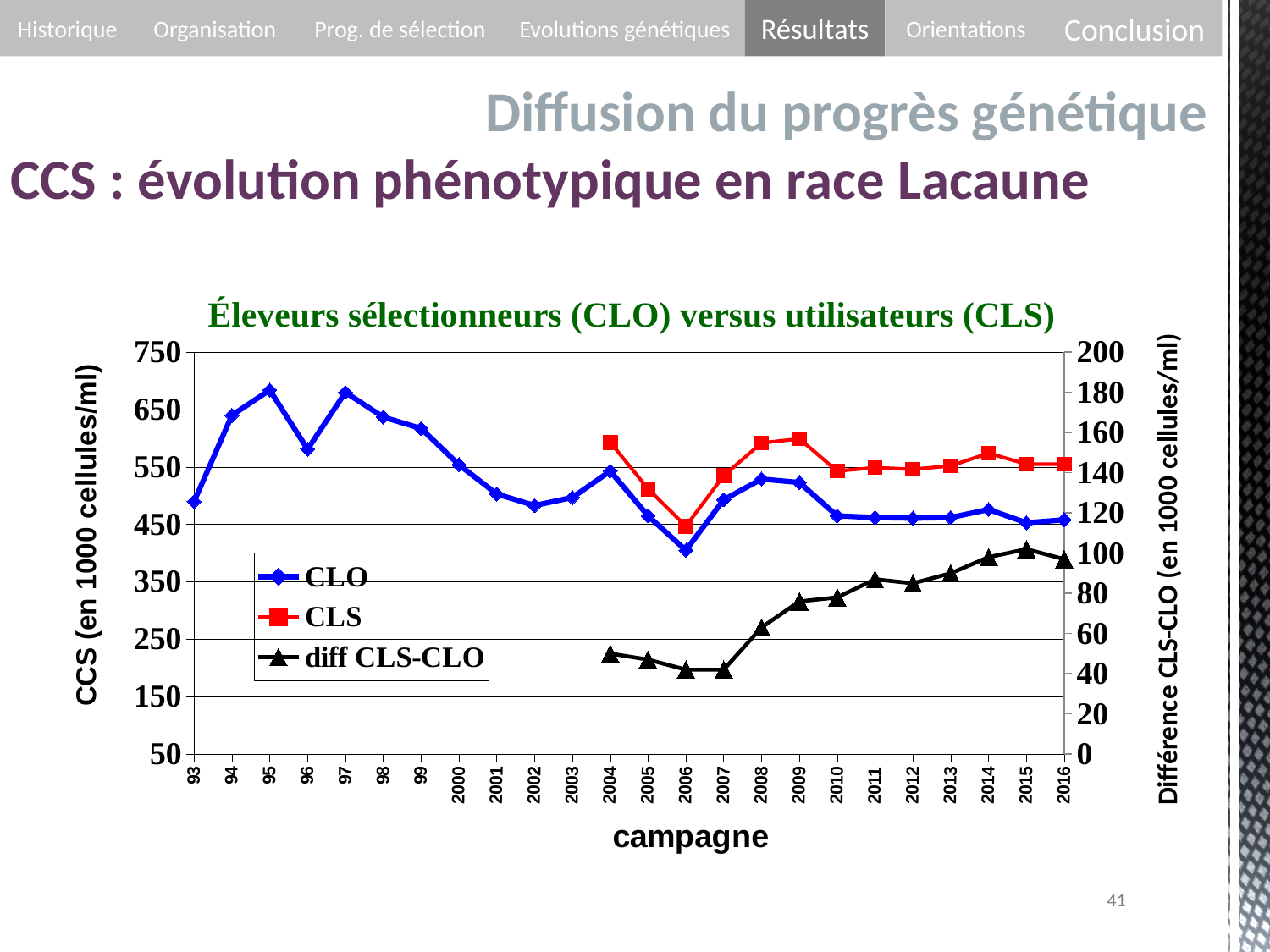
Is the diff CLS-CLO value for 2016 greater or less than 80 on the right axis? greater Which series are listed in the legend? CLO, CLS, diff CLS-CLO In 2016, which series has the higher CCS value, CLO or CLS? CLS In which campaign does the CLO series reach its lowest value? 2006 What kind of chart is shown on the slide? line chart How many series does the legend list? 3 In which campaign does the CLS series reach its lowest value? 2006 How many campaigns (years) are shown on the x axis? 24 Is the CLO value for 93 greater or less than 550? less Does the diff CLS-CLO series rise or fall from 2007 to 2015? rise Is the CLO value for 95 greater or less than 650? greater What is the title of the chart? Éleveurs sélectionneurs (CLO) versus utilisateurs (CLS)